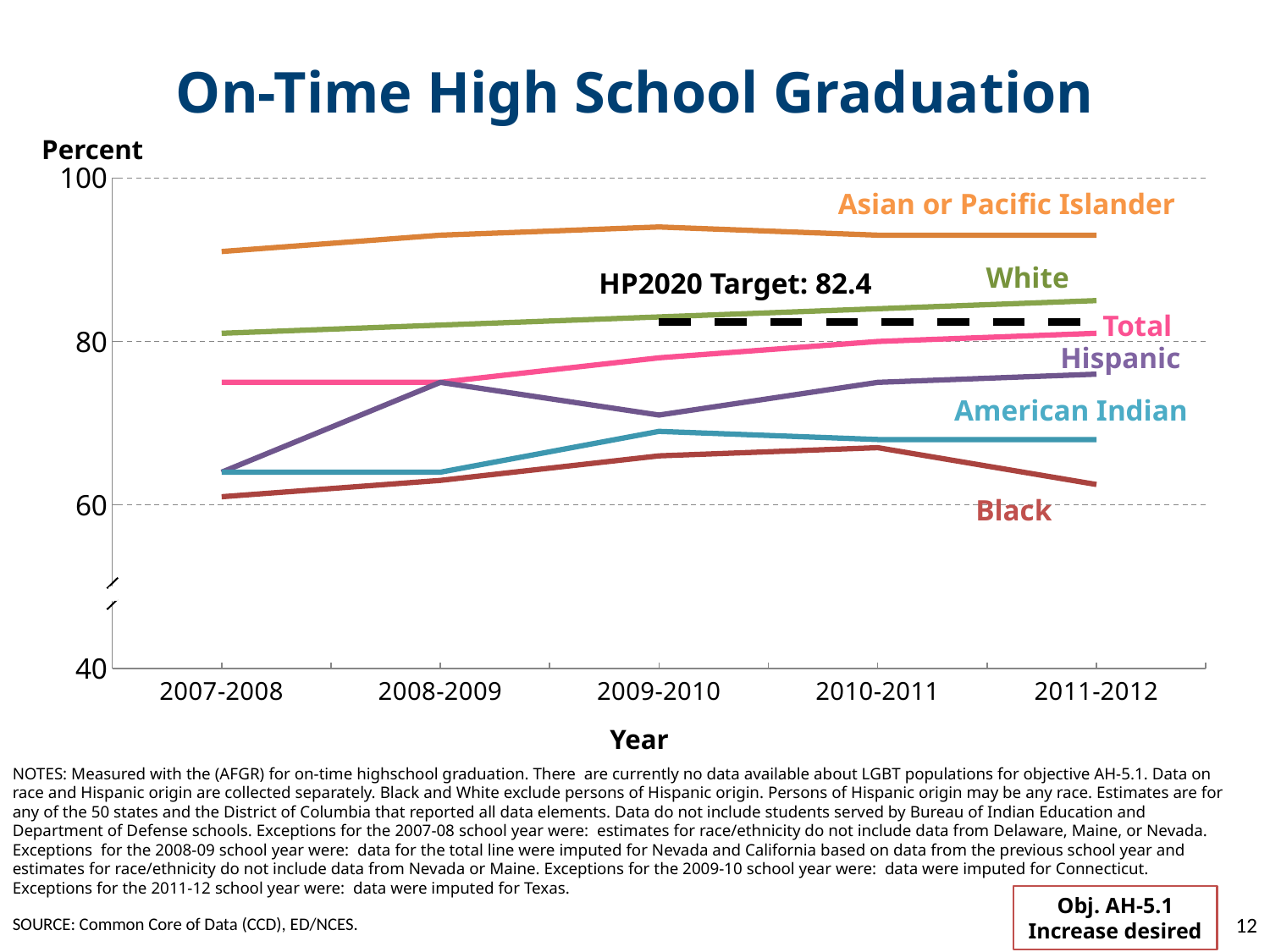
How many school years are shown on the x axis? 5 Which group has the lowest on-time graduation rate in 2011-2012? Black Is the value for Asian or Pacific Islander in 2007-2008 greater or less than 80? greater How many population groups are plotted as lines on the chart? 6 Which group has the highest on-time graduation rate in 2011-2012? Asian or Pacific Islander In 2009-2010, which is higher: White or Hispanic? White Is the value for White in 2011-2012 greater or less than 80? greater What is the HP2020 Target value shown on the chart? 82.4 Is the value for Total in 2007-2008 greater or less than 80? less What kind of chart is shown on the slide? line chart What is the label on the x axis of the chart? Year Does the White line rise or fall from 2007-2008 to 2011-2012? rise